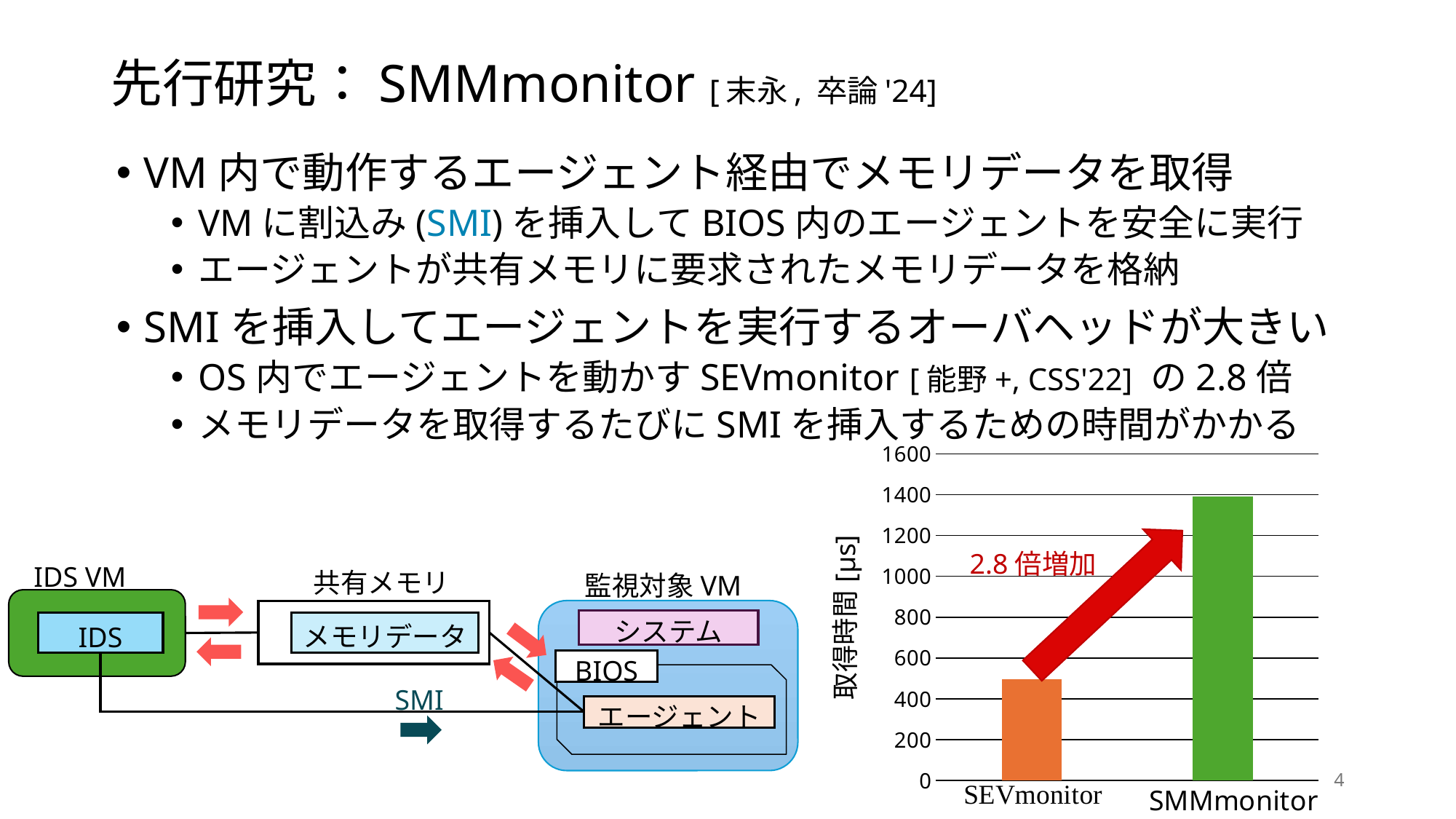
What is the label of the vertical axis of the bar chart? 取得時間 [µs] Is the value for SEVmonitor in the bar chart greater or less than 600? less Is the value for SMMmonitor in the bar chart greater or less than 1200? greater Which category has the lowest value in the bar chart? SEVmonitor Is the value for SEVmonitor in the bar chart greater or less than 400? greater In the bar chart, which is larger, the value for SEVmonitor or the value for SMMmonitor? SMMmonitor How many categories are plotted in the bar chart? 2 Which category has the highest value in the bar chart? SMMmonitor Do the values in the bar chart rise or fall from SEVmonitor to SMMmonitor? rise What kind of chart is shown on the right side of the slide? bar chart What text is written next to the red arrow in the bar chart? 2.8 倍増加